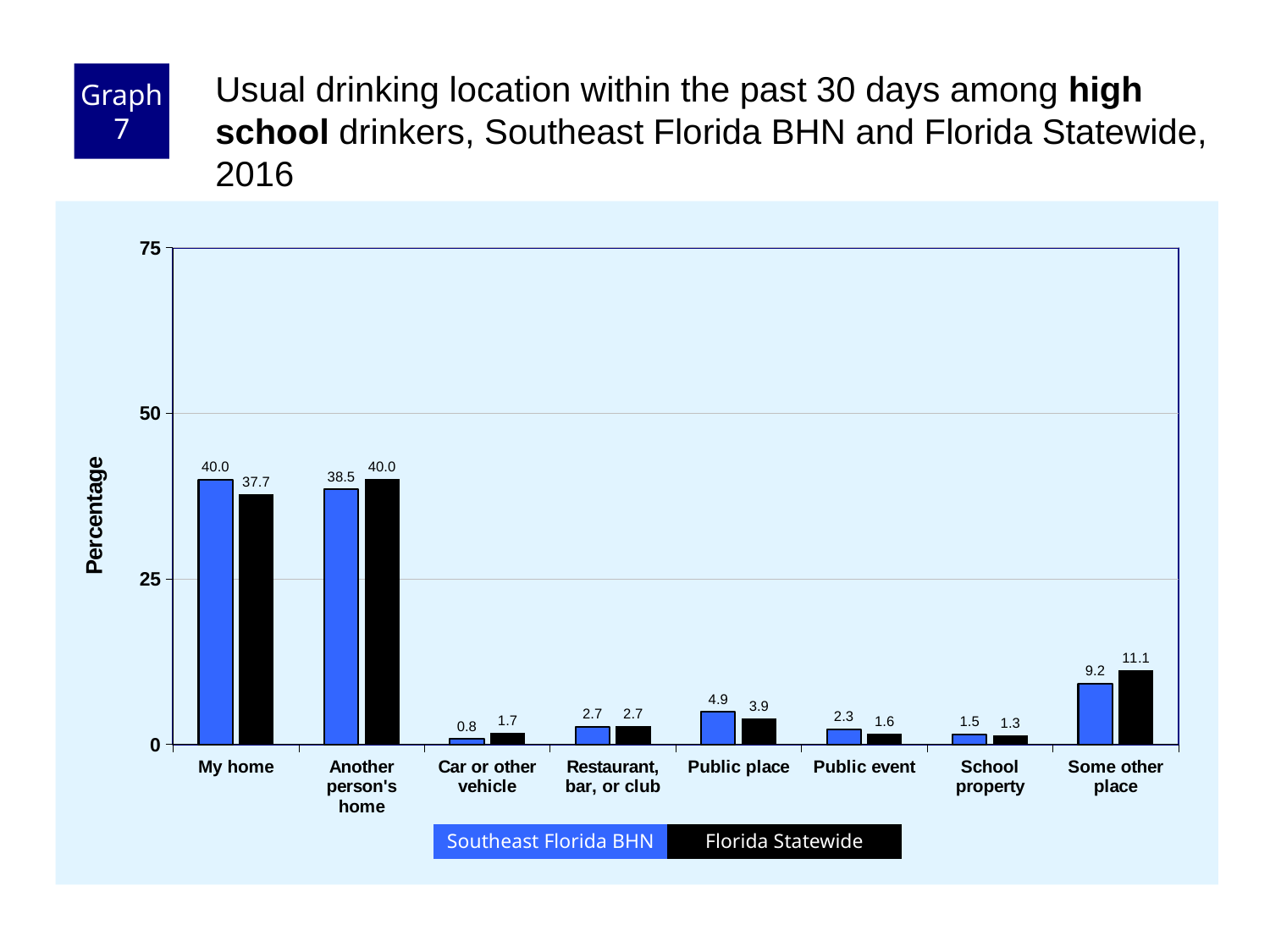
For Another person's home, which is larger: Southeast Florida BHN or Florida Statewide? Florida Statewide What kind of chart is shown on the slide? Bar chart How many series does the legend list? 2 How many categories are shown on the x axis? 8 What is the Southeast Florida BHN value for Public place? 4.9 What is the difference between the Florida Statewide and Southeast Florida BHN values for Some other place? 1.9 Is the Southeast Florida BHN value for My home greater or less than 25? greater What is the difference between the Southeast Florida BHN and Florida Statewide values for My home? 2.3 What is the Florida Statewide value for Some other place? 11.1 Which category has the lowest Southeast Florida BHN value? Car or other vehicle Which category has the highest Florida Statewide value? Another person's home What is the Southeast Florida BHN value for My home? 40.0